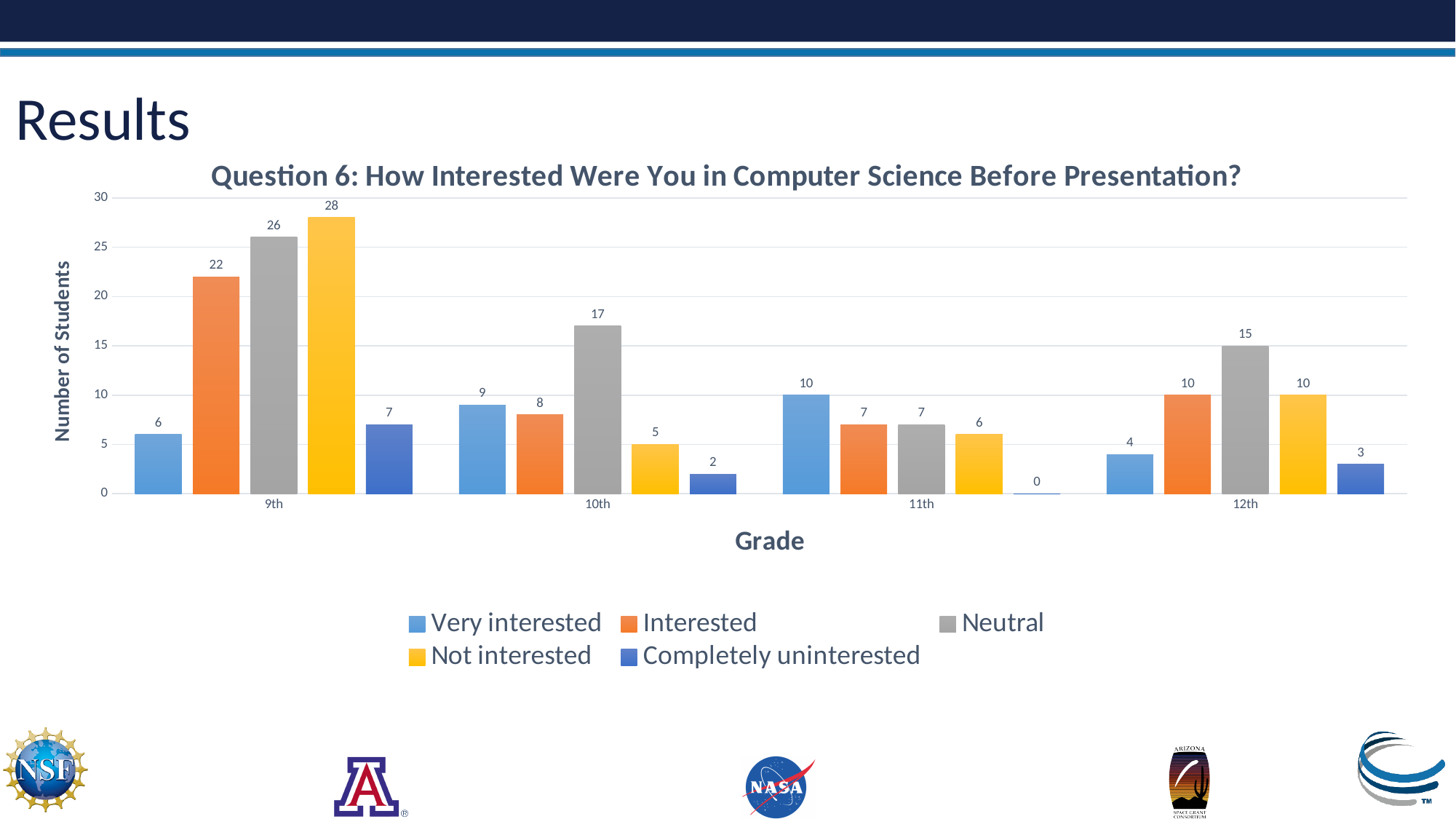
How many series does the legend list? 5 What is the value for "Neutral" in 10th grade? 17 What is the label of the y axis? Number of Students Which is larger for 12th grade: "Neutral" or "Interested"? Neutral What is the value for "Very interested" in 12th grade? 4 What kind of chart is shown on the slide? Bar chart How many 11th grade students were "Completely uninterested"? 0 What is the difference between the "Not interested" and "Very interested" values for 9th grade? 22 Which grade has the lowest "Neutral" value? 11th How many 9th grade students answered "Not interested"? 28 Which grade has the highest "Interested" value? 9th How many grade categories are shown on the x axis? 4